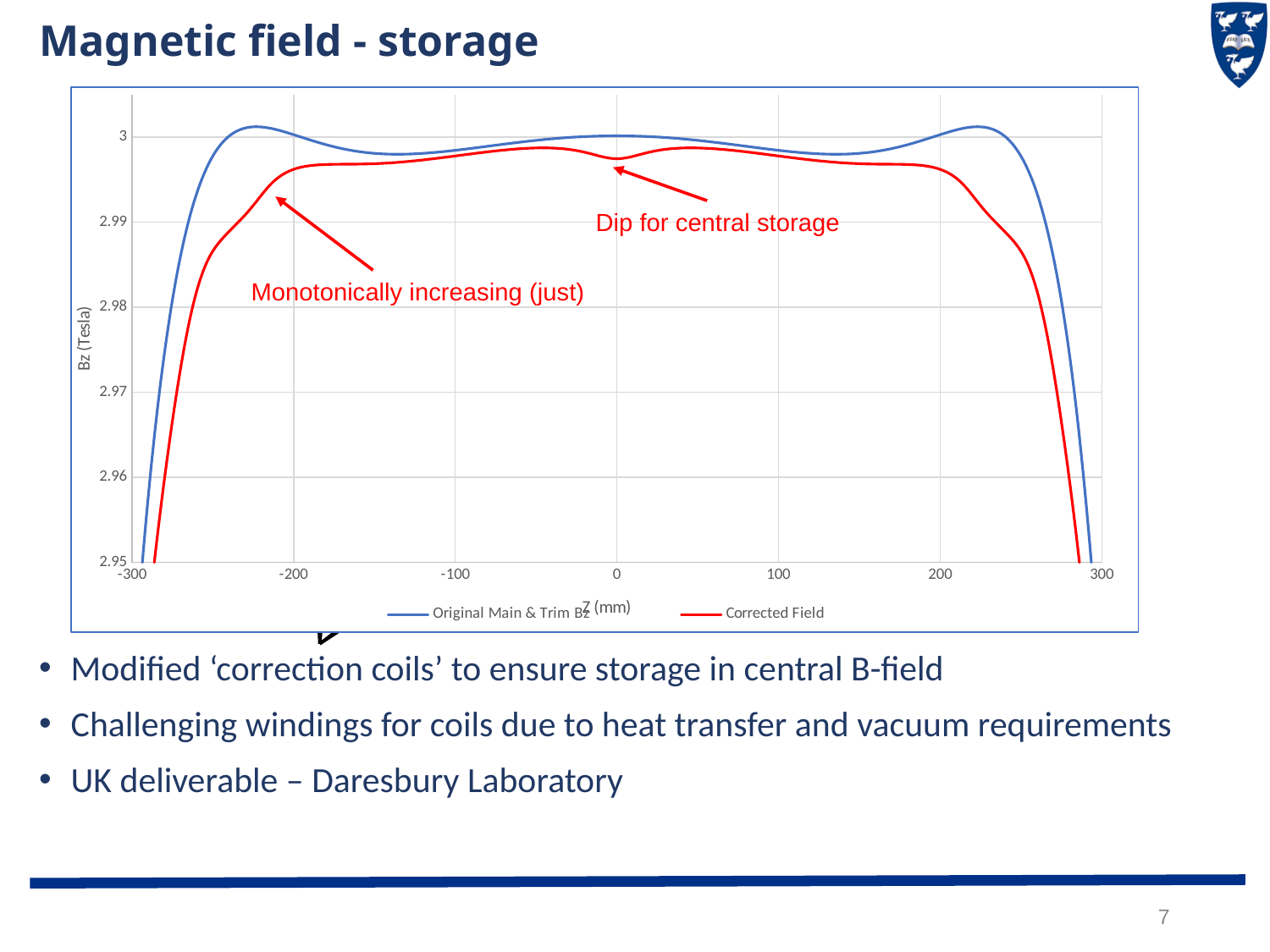
Is the Corrected Field value at Z = -280 mm greater or less than 2.98 Tesla? less At Z = -250 mm, which series has the higher Bz value, Original Main & Trim Bz or Corrected Field? Original Main & Trim Bz How many series does the legend list? 2 Does the Original Main & Trim Bz series rise or fall as Z goes from 250 mm to 300 mm? fall What kind of chart is shown on the slide? line chart Is the Corrected Field value at Z = 200 mm greater or less than 2.99 Tesla? greater Does the Corrected Field rise or fall as Z goes from -300 mm to -200 mm? rise Which series is drawn in red? Corrected Field Is the Corrected Field value at Z = 0 mm greater or less than 2.99 Tesla? greater At Z = 0 mm, which series has the higher Bz value, Original Main & Trim Bz or Corrected Field? Original Main & Trim Bz What are the two series named in the legend? Original Main & Trim Bz; Corrected Field